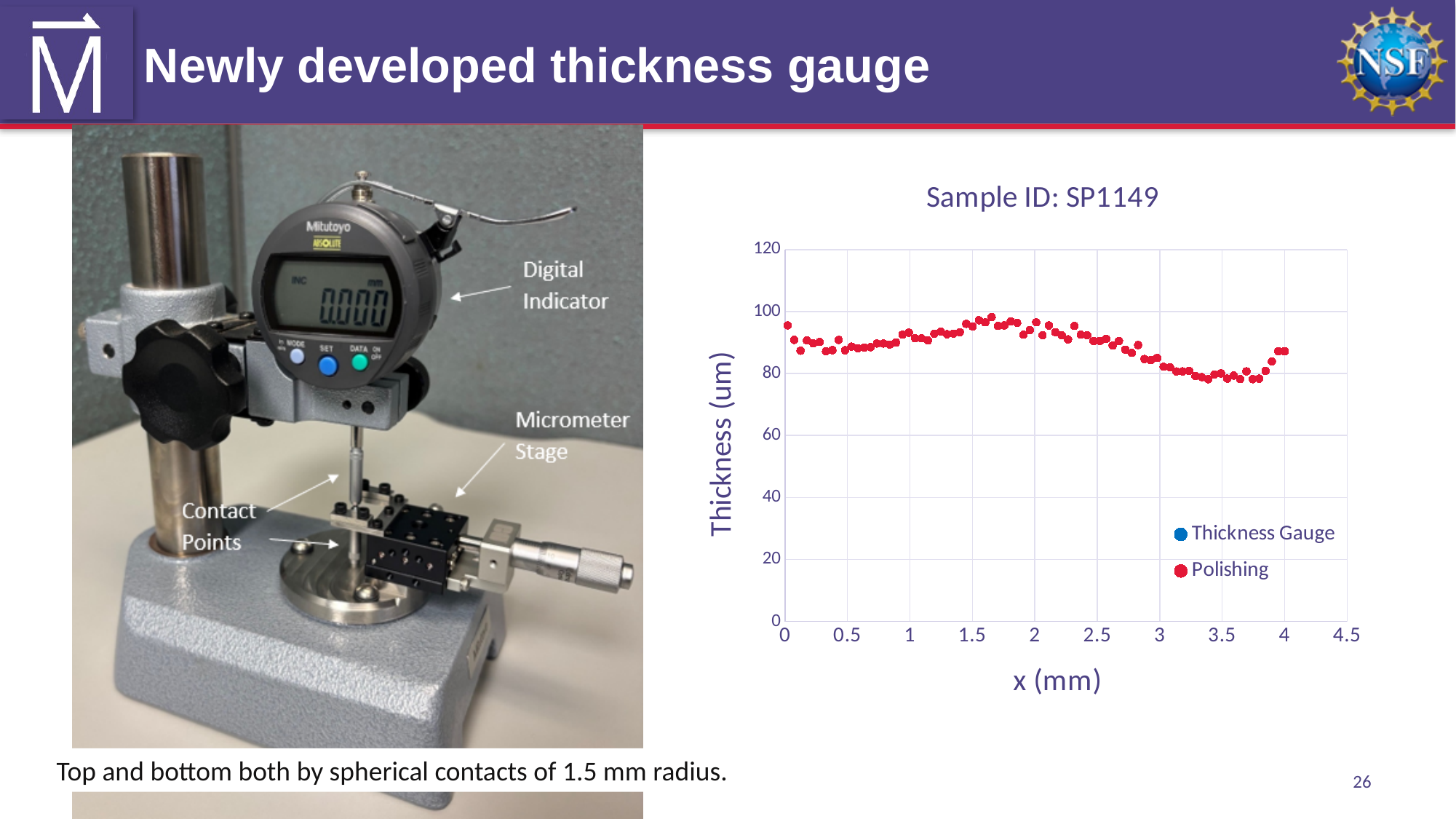
How many series does the chart legend list? 2 What kind of chart is shown on the slide? scatter chart What is the title of the chart? Sample ID: SP1149 What is the label of the y axis of the chart? Thickness (um) Do the thickness values rise or fall as x increases from 2 mm to 3.5 mm? fall Which is larger, the thickness near x = 1.6 mm or the thickness near x = 3.4 mm? near x = 1.6 mm Is the thickness value near x = 1.6 mm greater or less than 80? greater Do the thickness values rise or fall as x increases from 0.5 mm to 1.6 mm? rise Are all plotted thickness values below 100 um? yes Is the thickness value at x = 0 mm greater or less than 80? greater